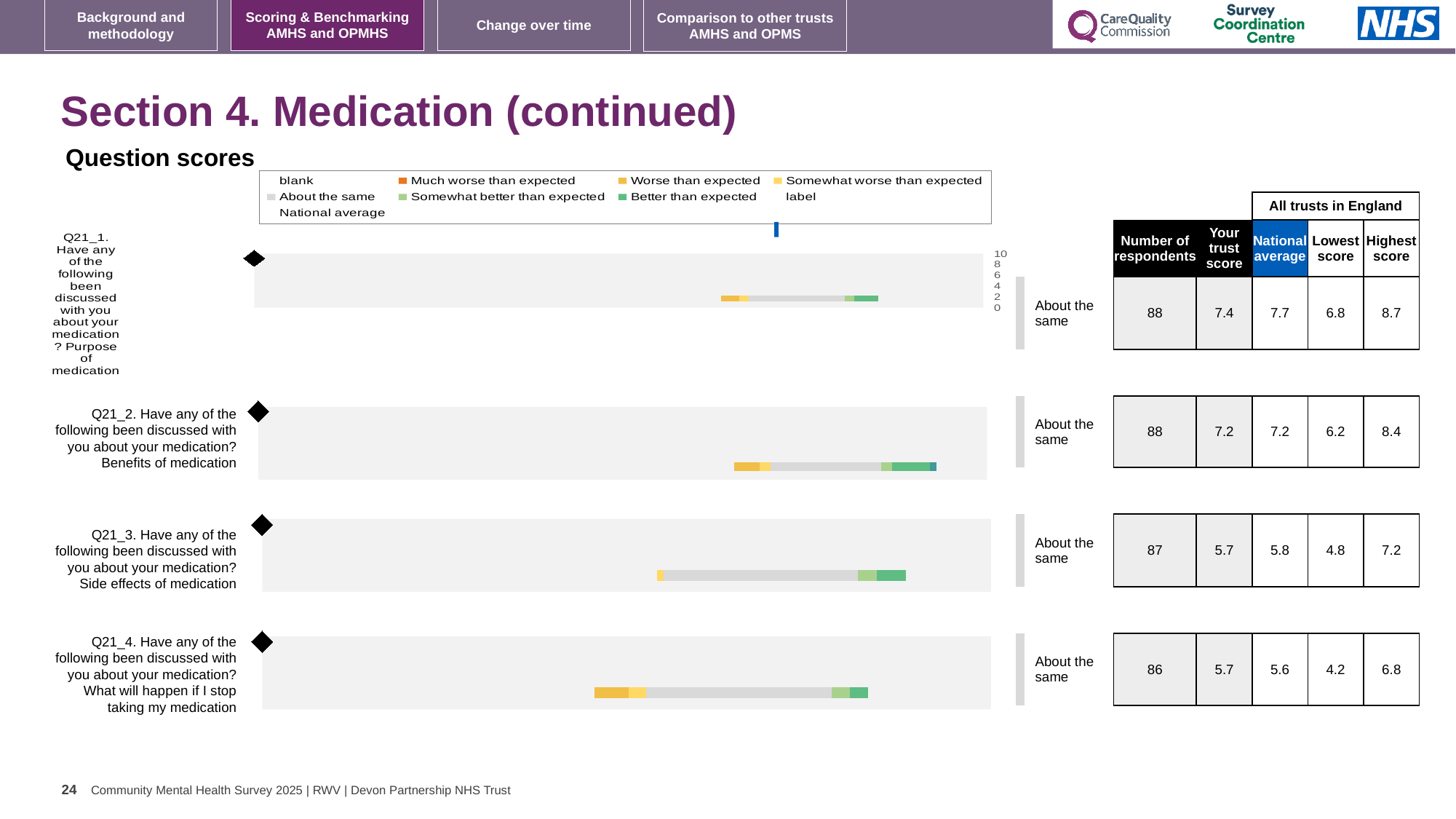
How many questions (chart rows) are plotted on this slide? 4 For Q21_1 (Purpose of medication), what is the difference between the highest score and the lowest score among all trusts in England? 1.9 What kind of chart is used to show the question scores on this slide? bar chart What is the national average for Q21_1 (Purpose of medication)? 7.7 Which question has the highest 'Your trust score'? Q21_1 (Purpose of medication) What is the benchmark label shown next to the chart for Q21_1 (Purpose of medication)? About the same For Q21_4 (What will happen if I stop taking my medication), which is larger: the trust score or the national average? the trust score (5.7) What is the highest score among all trusts in England for Q21_4 (What will happen if I stop taking my medication)? 6.8 What is the 'Your trust score' for Q21_2 (Benefits of medication)? 7.2 How many respondents answered Q21_4 (What will happen if I stop taking my medication)? 86 What colour does the legend use for 'Better than expected'? green What is the lowest score among all trusts in England for Q21_3 (Side effects of medication)? 4.8